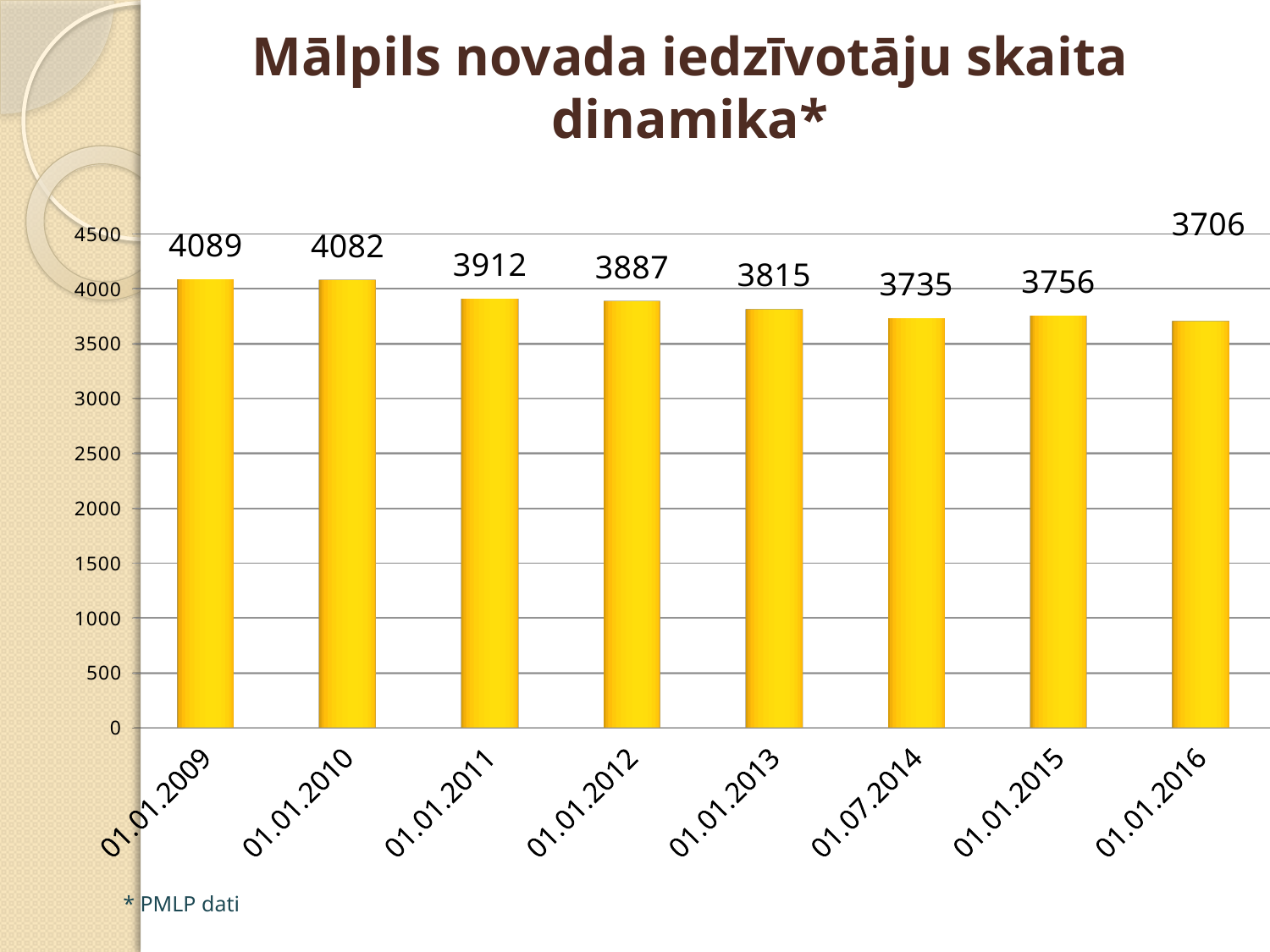
How many dates are shown on the x axis? 8 What is the title of the chart? Mālpils novada iedzīvotāju skaita dinamika* What is the value for 01.01.2009? 4089 Do the values generally rise or fall from 01.01.2009 to 01.01.2016? fall Is the value for 01.01.2013 greater or less than 4000? less Which date has the highest value? 01.01.2009 Which is larger, the value for 01.01.2015 or the value for 01.07.2014? 01.01.2015 What kind of chart is shown on the slide? bar chart What is the difference between the values for 01.01.2009 and 01.01.2016? 383 What is the value for 01.01.2016? 3706 What is the value for 01.07.2014? 3735 Which date has the lowest value? 01.01.2016